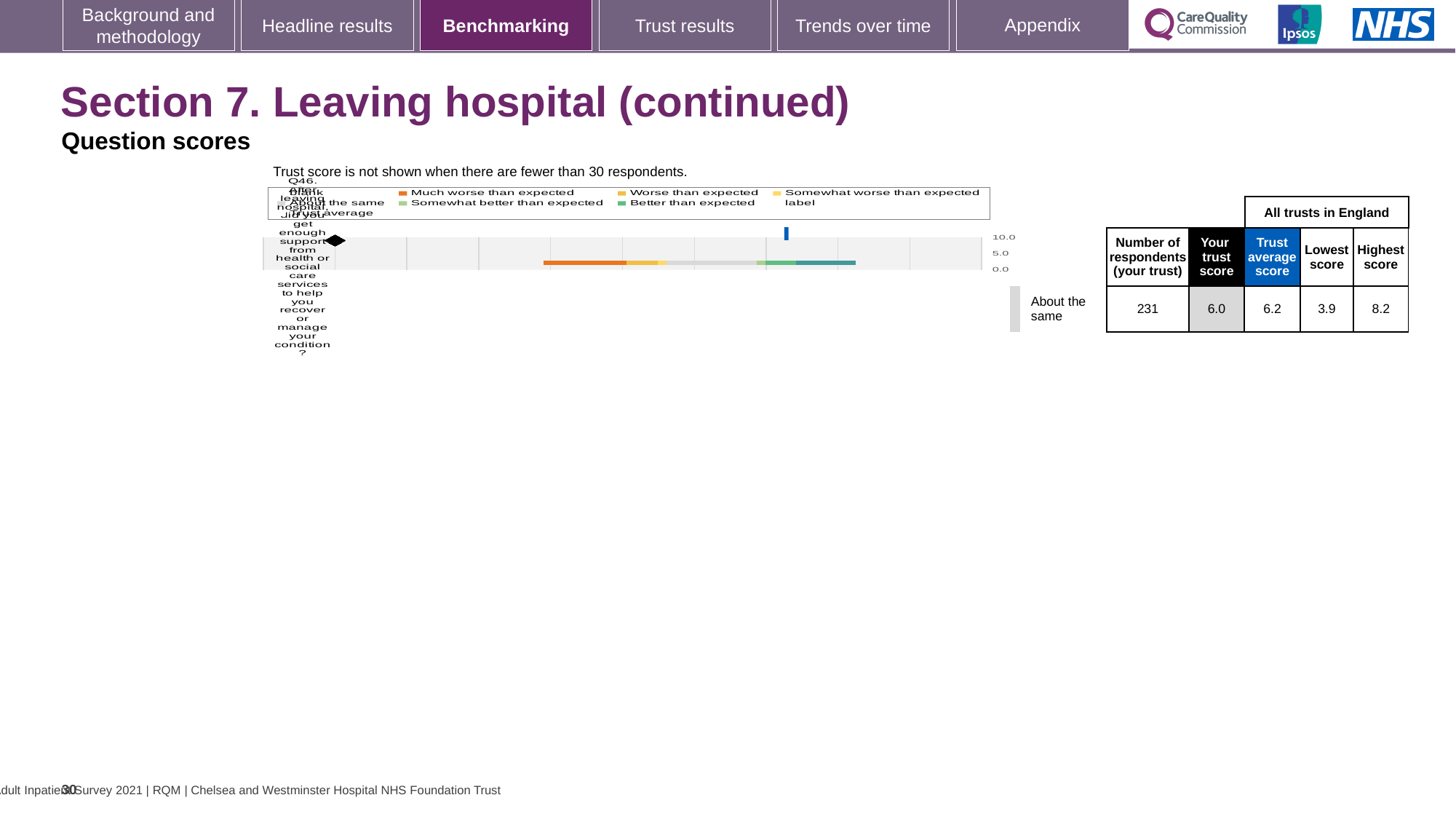
How many respondents from the trust answered Q46? 231 Is the trust score for Q46 greater or less than 5.0 on the chart's axis? greater What kind of chart is used to show the Q46 benchmarking result? Bar chart What is the trust average score for Q46 across all trusts in England? 6.2 What is the highest score among all trusts in England for Q46? 8.2 What is the difference between the highest score and the lowest score for Q46? 4.3 How many questions are plotted on the chart? 1 Which is larger for Q46: your trust score or the trust average score? Trust average score What is the trust score for Q46 shown in the table next to the chart? 6.0 What is the difference between the trust average score and your trust score for Q46? 0.2 What is the lowest score among all trusts in England for Q46? 3.9 What benchmark category is the trust's Q46 result placed in? About the same